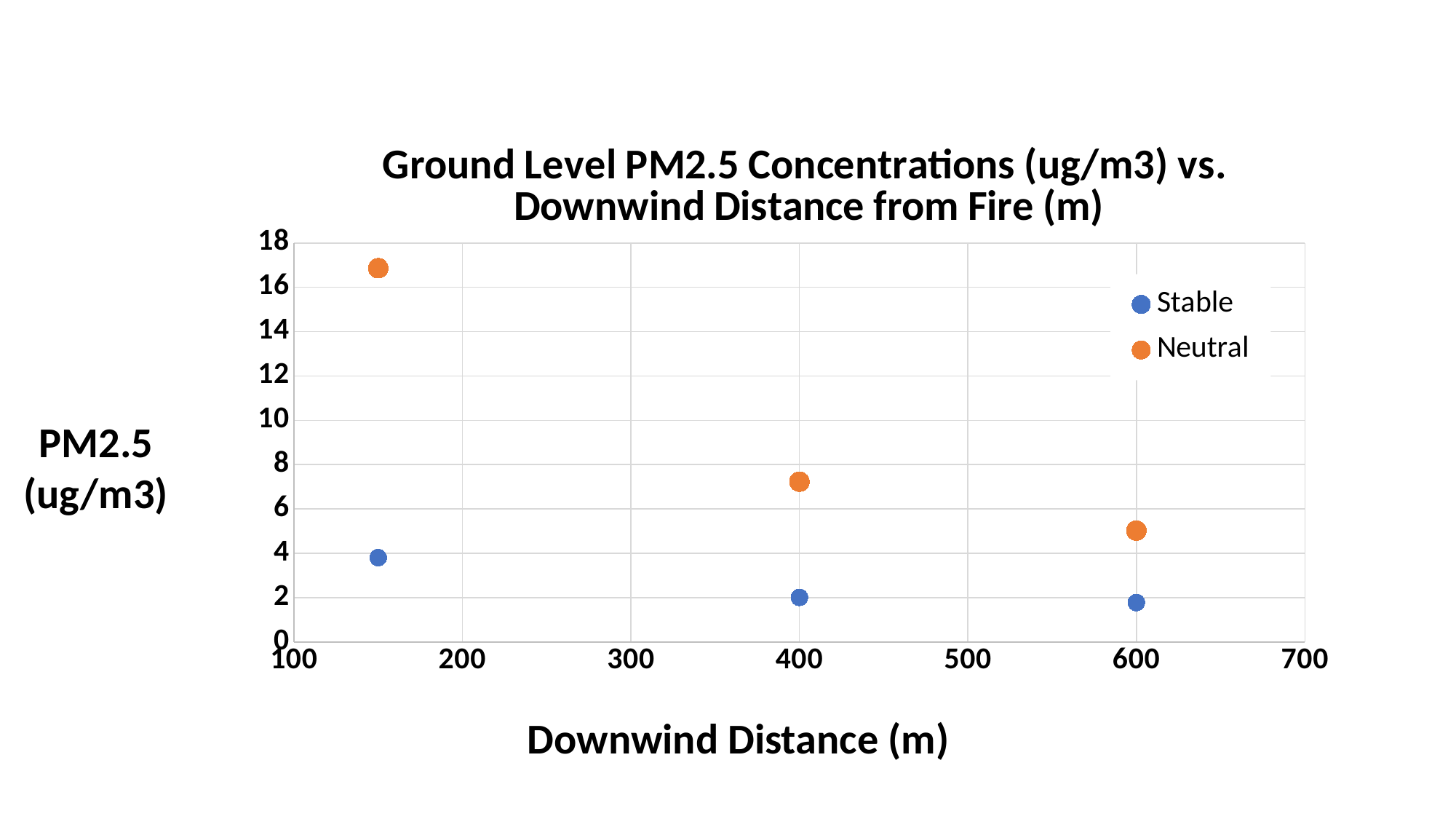
Is the PM2.5 value for the Neutral series at 150 m greater or less than 14? greater Which colour represents the Stable series in the legend? blue How many data points are plotted for the Neutral series? 3 Does the PM2.5 concentration for the Neutral series rise or fall as downwind distance increases? fall Is the PM2.5 value for the Stable series at 150 m greater or less than 2? greater What kind of chart is shown on the slide? scatter chart How many series does the legend list? 2 Is the PM2.5 value for the Neutral series at 600 m greater or less than 6? less At a downwind distance of 400 m, which series has the higher PM2.5 concentration, Stable or Neutral? Neutral What is the label of the x axis? Downwind Distance (m)